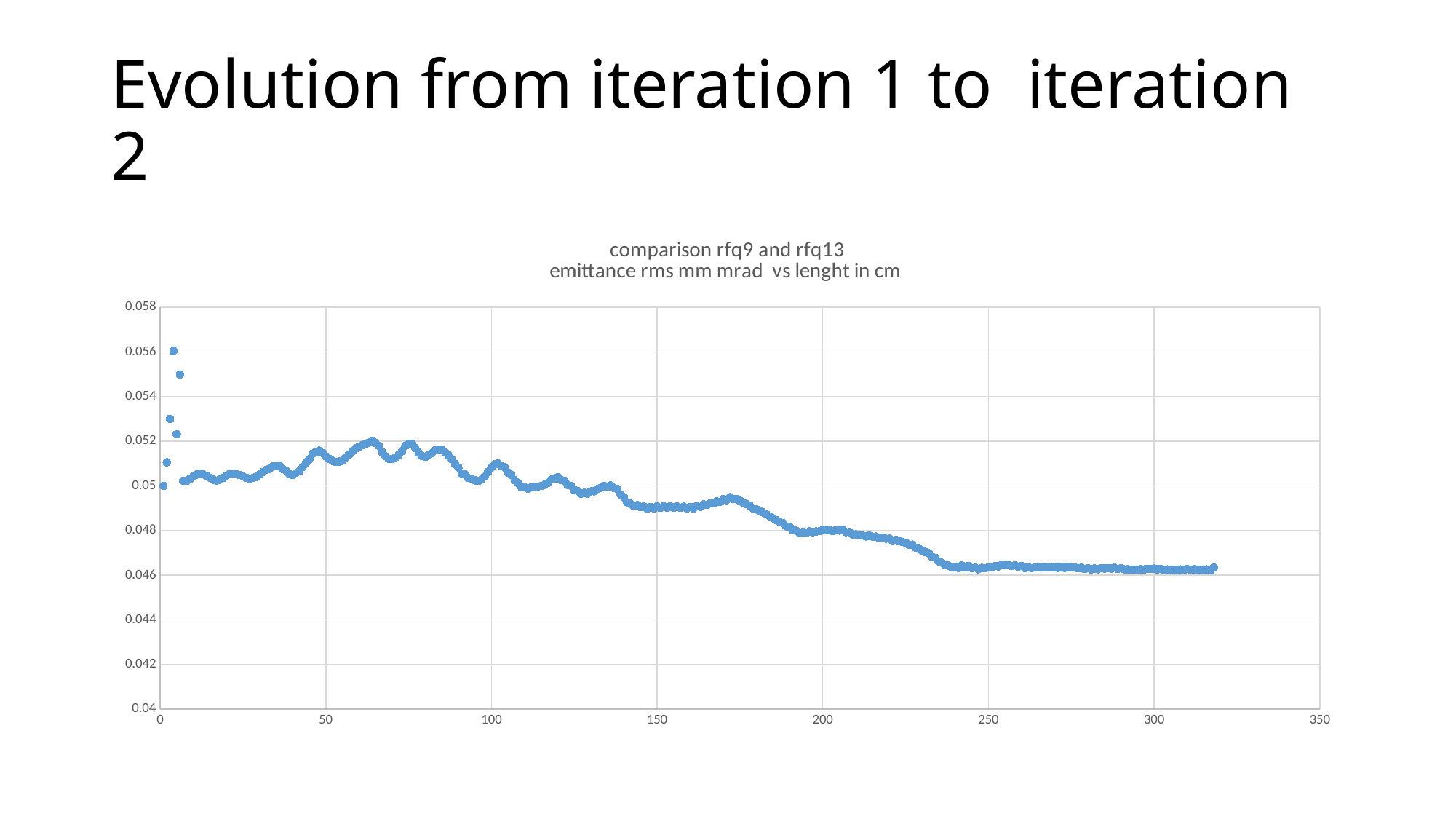
Which is larger, the value at a length of 100 cm or the value at a length of 300 cm? 100 cm What is the highest value shown on the chart's vertical axis? 0.058 Overall, do the plotted values rise or fall as length increases from 0 to about 320 cm? fall What is the title of the chart? comparison rfq9 and rfq13 emittance rms mm mrad vs lenght in cm Is the value at a length of 200 cm greater or less than 0.046? greater Is the value at a length of 100 cm greater or less than 0.054? less Is the value at a length of 50 cm greater or less than 0.05? greater Which is larger, the value at a length of 50 cm or the value at a length of 250 cm? 50 cm Which is larger, the value at a length of 175 cm or the value at a length of 225 cm? 175 cm What kind of chart is shown on the slide? scatter chart